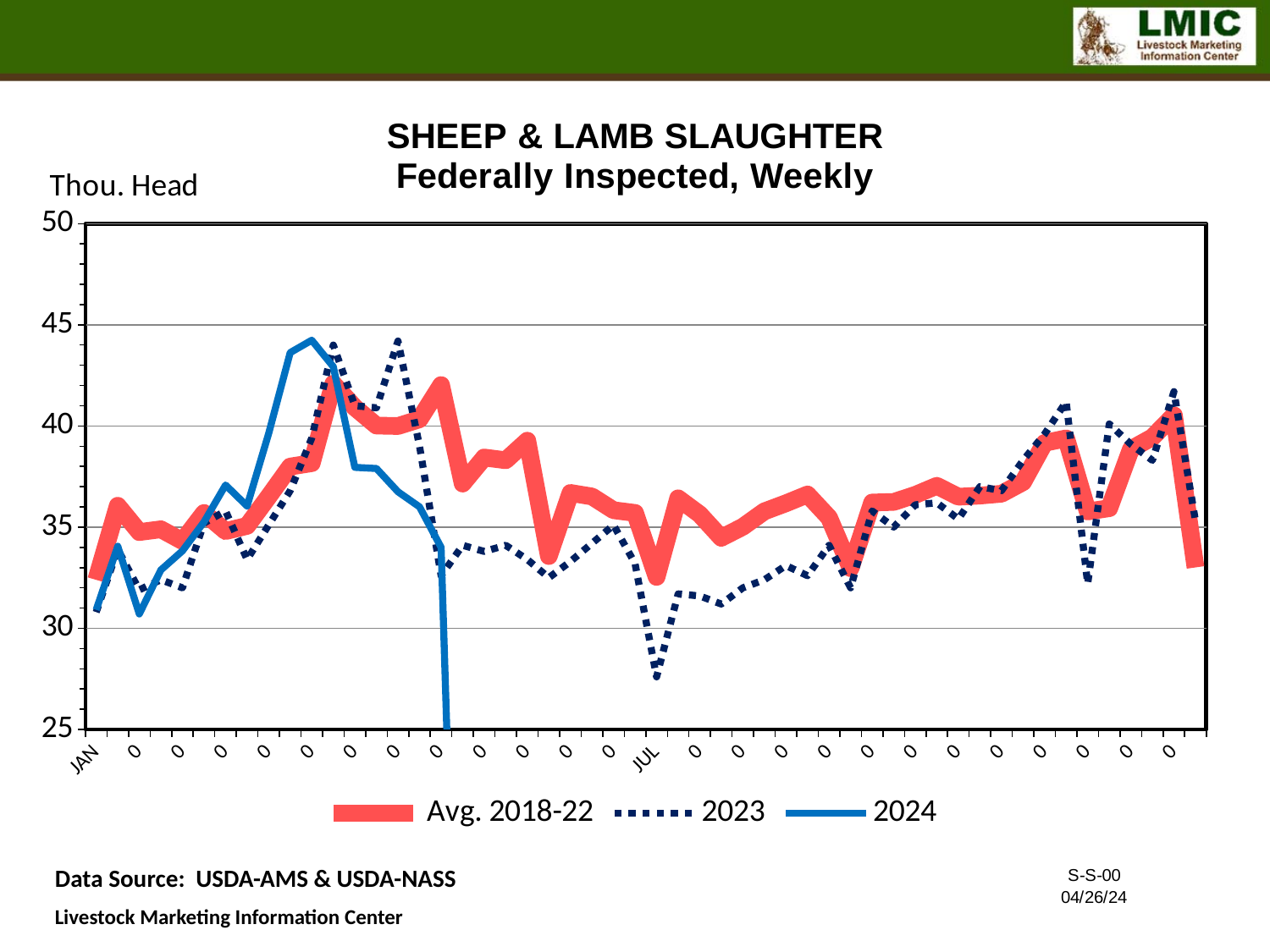
Is the peak value of the 2024 line greater or less than 40? greater Is the value of the Avg. 2018-22 line at JUL greater or less than 30? greater How many series does the legend list? 3 At JUL, which series is higher: Avg. 2018-22 or 2023? Avg. 2018-22 Does the 2024 line rise or fall from JAN to its peak in the first quarter of the year? rise Which series is plotted as a dotted line? 2023 Is the value of the Avg. 2018-22 line at JAN greater or less than 35? less What is the title of the chart? SHEEP & LAMB SLAUGHTER Federally Inspected, Weekly What unit is shown on the y axis of the chart? Thou. Head What kind of chart is shown on the slide? line chart